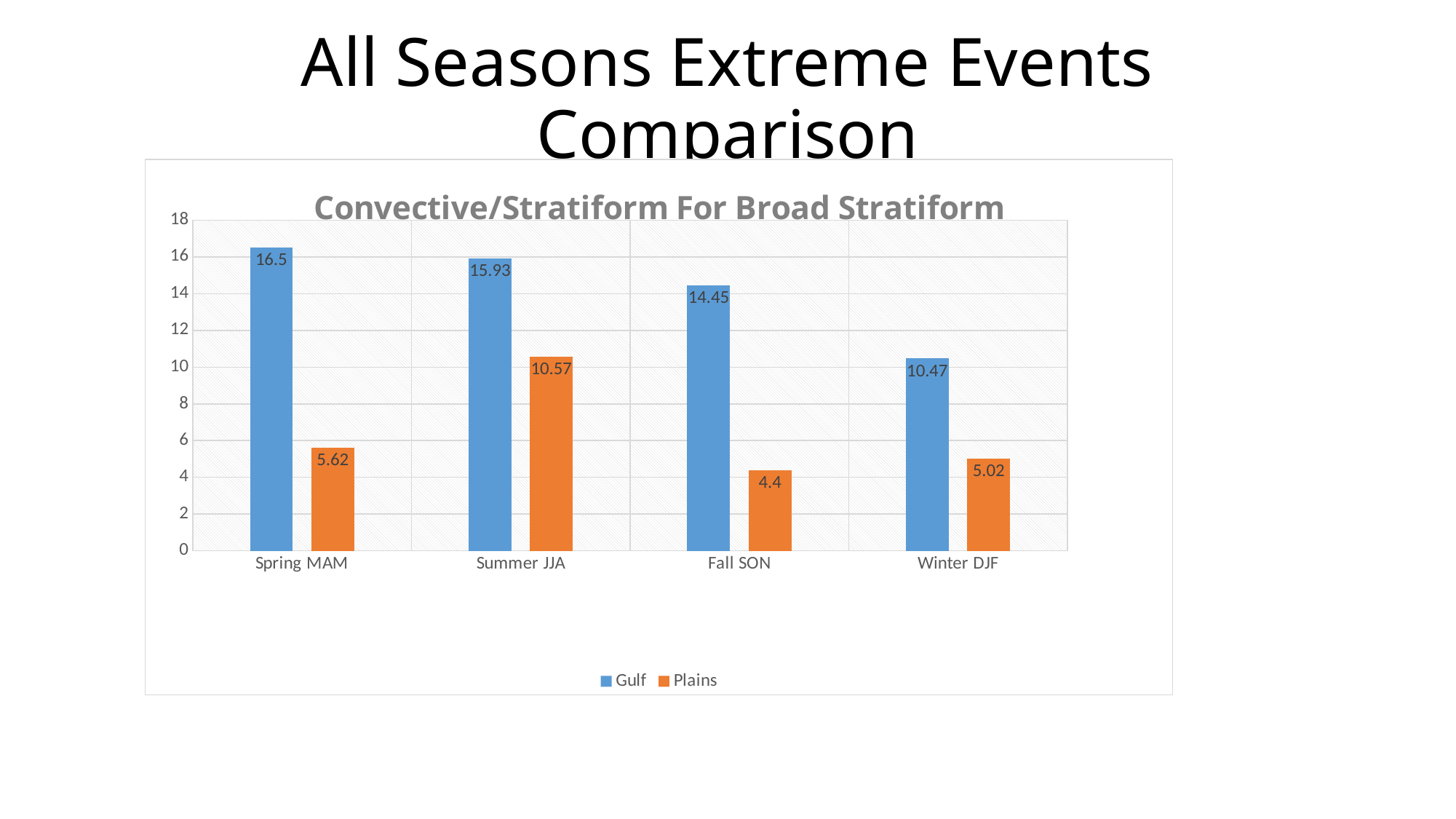
How many seasons are shown on the x axis? 4 What is the Plains value for Fall SON? 4.4 Which season has the lowest Plains value? Fall SON Which is larger for Winter DJF, the Gulf value or the Plains value? Gulf How many series does the legend list? 2 Which season has the highest Gulf value? Spring MAM Is the Gulf value for Summer JJA greater or less than 14? greater What is the Plains value for Summer JJA? 10.57 What kind of chart is shown on the slide? Bar chart What is the difference between the Gulf and Plains values for Fall SON? 10.05 What is the Gulf value for Winter DJF? 10.47 What is the Gulf value for Spring MAM? 16.5